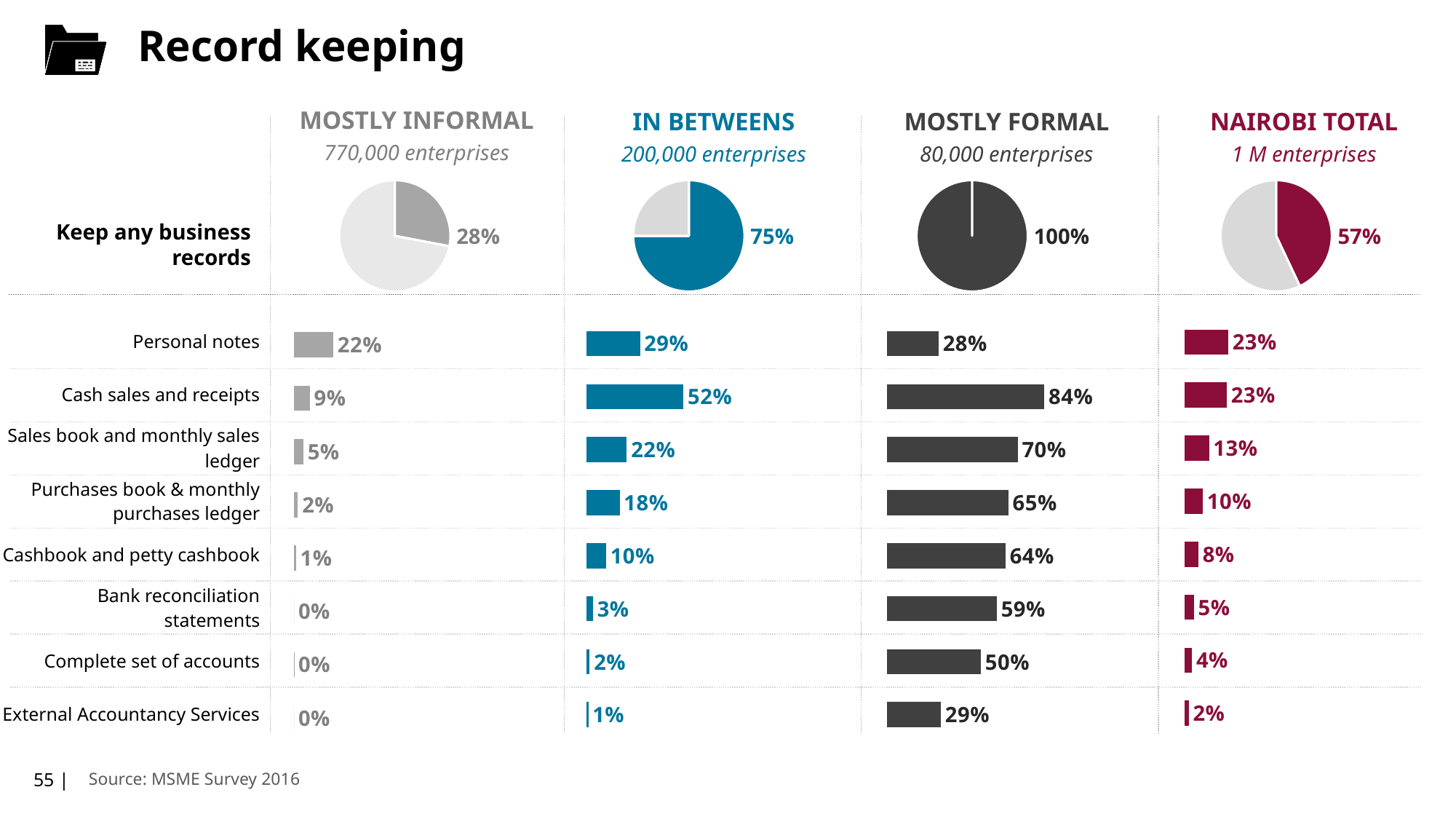
How many enterprises are in the In Betweens group according to the column header? 200,000 enterprises In the Mostly Formal column, what is the value for Cash sales and receipts? 84% In the In Betweens column, what is the value for Purchases book & monthly purchases ledger? 18% What kind of chart is used to show the share that keep any business records in each column? Pie chart In the Nairobi Total column, what percentage keep any business records according to the pie chart? 57% In the In Betweens column, which record type has the highest value among the bars? Cash sales and receipts Which is larger: the In Betweens value for Personal notes or the Mostly Formal value for Personal notes? In Betweens In the Mostly Formal column, which record type has the lowest value among the bars? Personal notes In the Mostly Informal column, what percentage keep any business records according to the pie chart? 28% How many record types are listed as bar rows below the pie charts? 8 In the Nairobi Total column, do the bar values rise or fall going down the list from Personal notes to External Accountancy Services? Fall What is the difference between the Mostly Formal and Mostly Informal values for Cash sales and receipts? 75%